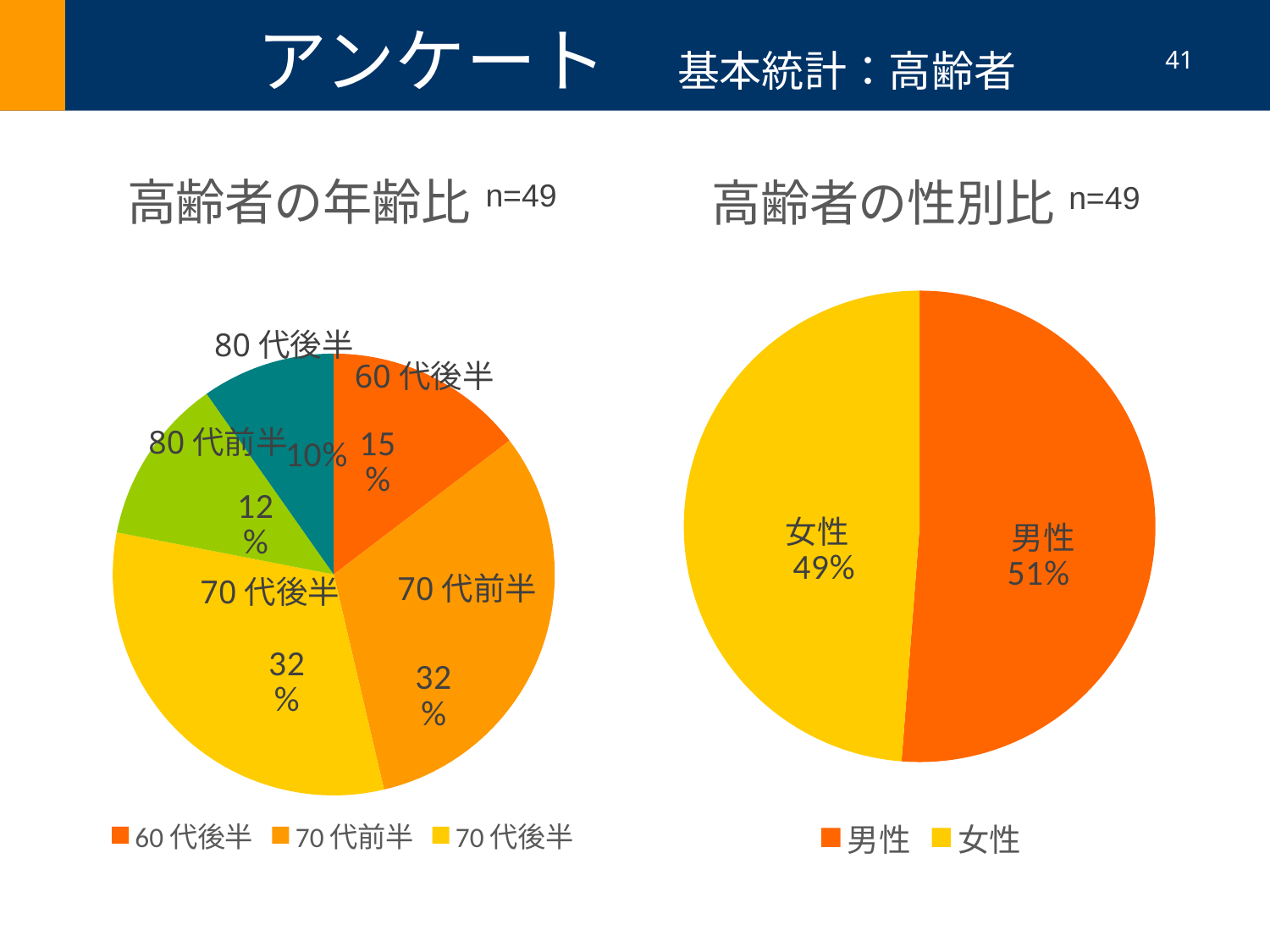
How many entries does the legend of the 高齢者の性別比 chart list? 2 In the 高齢者の年齢比 chart, what is the difference between the shares of 70 代前半 and 60 代後半? 17% In the 高齢者の性別比 chart, which is larger, 男性 or 女性? 男性 What type of chart is the 高齢者の性別比 chart? Pie chart In the 高齢者の性別比 chart, what percentage is shown for 男性? 51% In the 高齢者の年齢比 chart, which is larger, 80 代前半 or 80 代後半? 80 代前半 How many slices does the 高齢者の年齢比 pie chart have? 5 In the 高齢者の年齢比 chart, what percentage is shown for 80 代前半? 12% In the 高齢者の年齢比 chart, what percentage is shown for 60 代後半? 15% In the 高齢者の性別比 chart, what is the difference between the 男性 and 女性 shares? 2% In the 高齢者の年齢比 chart, which category has the smallest share? 80 代後半 In the 高齢者の年齢比 chart, what percentage is shown for 80 代後半? 10%